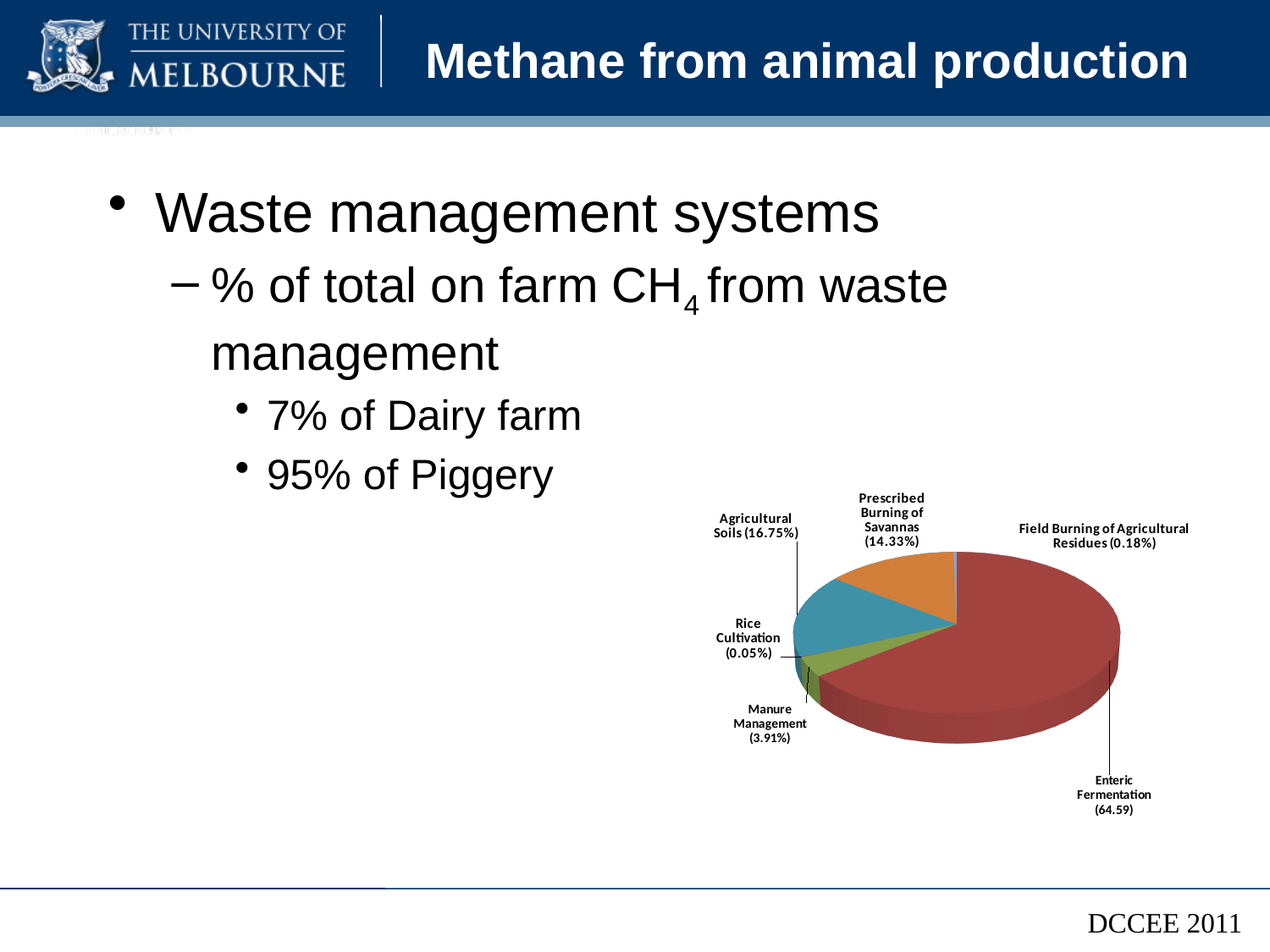
What is the value shown for Manure Management in the pie chart? 3.91% What is the value shown for Field Burning of Agricultural Residues in the pie chart? 0.18% What is the value shown for Rice Cultivation in the pie chart? 0.05% What is the difference between the Agricultural Soils and Manure Management values in the pie chart? 12.84% What is the value shown for Agricultural Soils in the pie chart? 16.75% Which is larger in the pie chart, Agricultural Soils or Prescribed Burning of Savannas? Agricultural Soils What is the value shown for Enteric Fermentation in the pie chart? 64.59 What is the value shown for Prescribed Burning of Savannas in the pie chart? 14.33% What kind of chart is shown on the slide? pie chart How many slices does the pie chart have? 6 Which category has the smallest slice in the pie chart? Rice Cultivation Which category has the largest slice in the pie chart? Enteric Fermentation